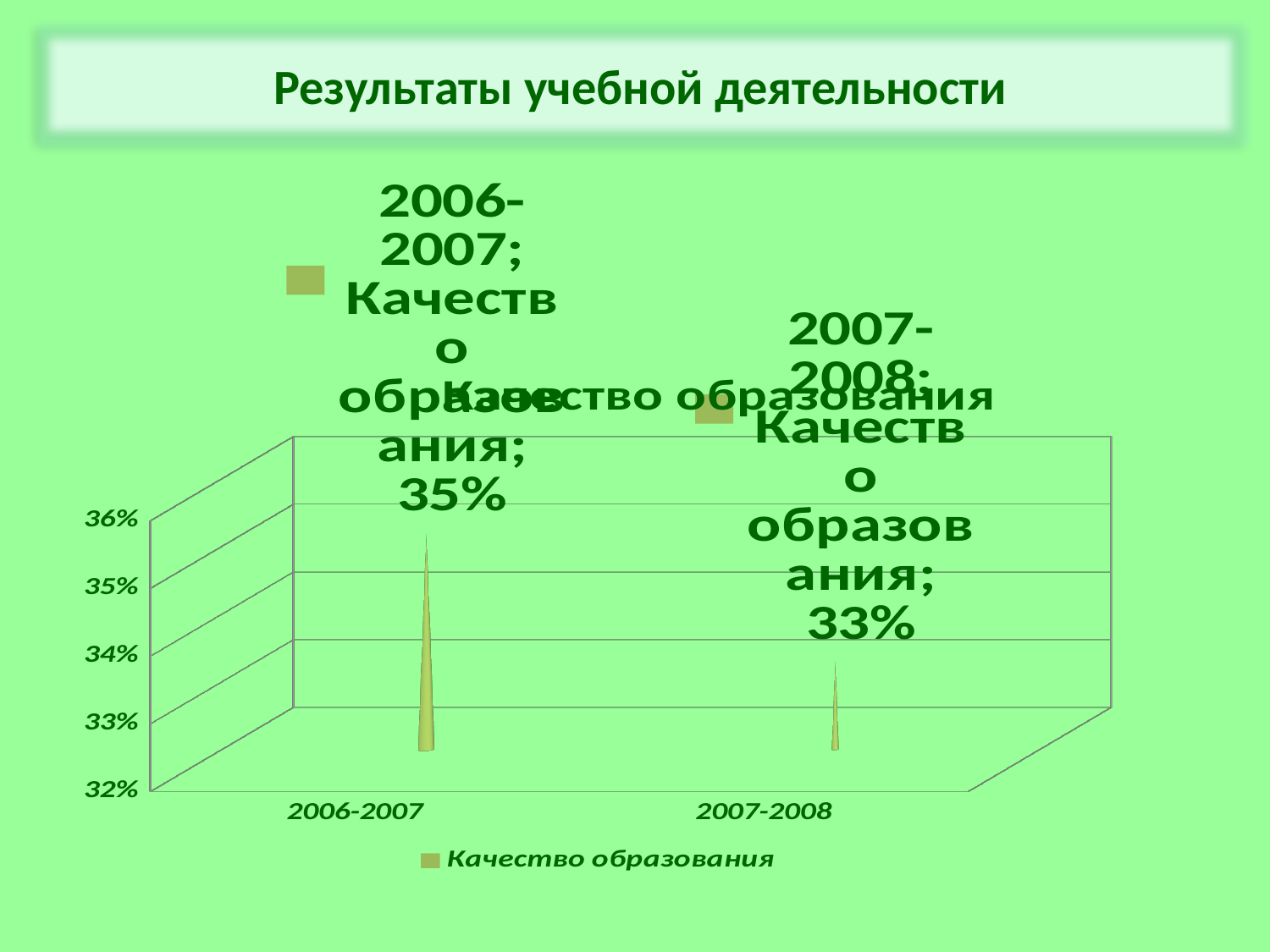
How many series does the legend list? 1 Which category has the lowest value? 2007-2008 Which category has the highest value? 2006-2007 Is the value for 2006-2007 greater or less than 34%? greater How many categories are shown on the x axis? 2 Is the value for 2007-2008 greater or less than 34%? less Which is larger, the value for 2006-2007 or the value for 2007-2008? 2006-2007 What is the difference between the values for 2006-2007 and 2007-2008? 2% What is the value for 2006-2007? 35% What is the value for 2007-2008? 33% What kind of chart is shown on the slide? bar chart Do the values rise or fall from 2006-2007 to 2007-2008? fall